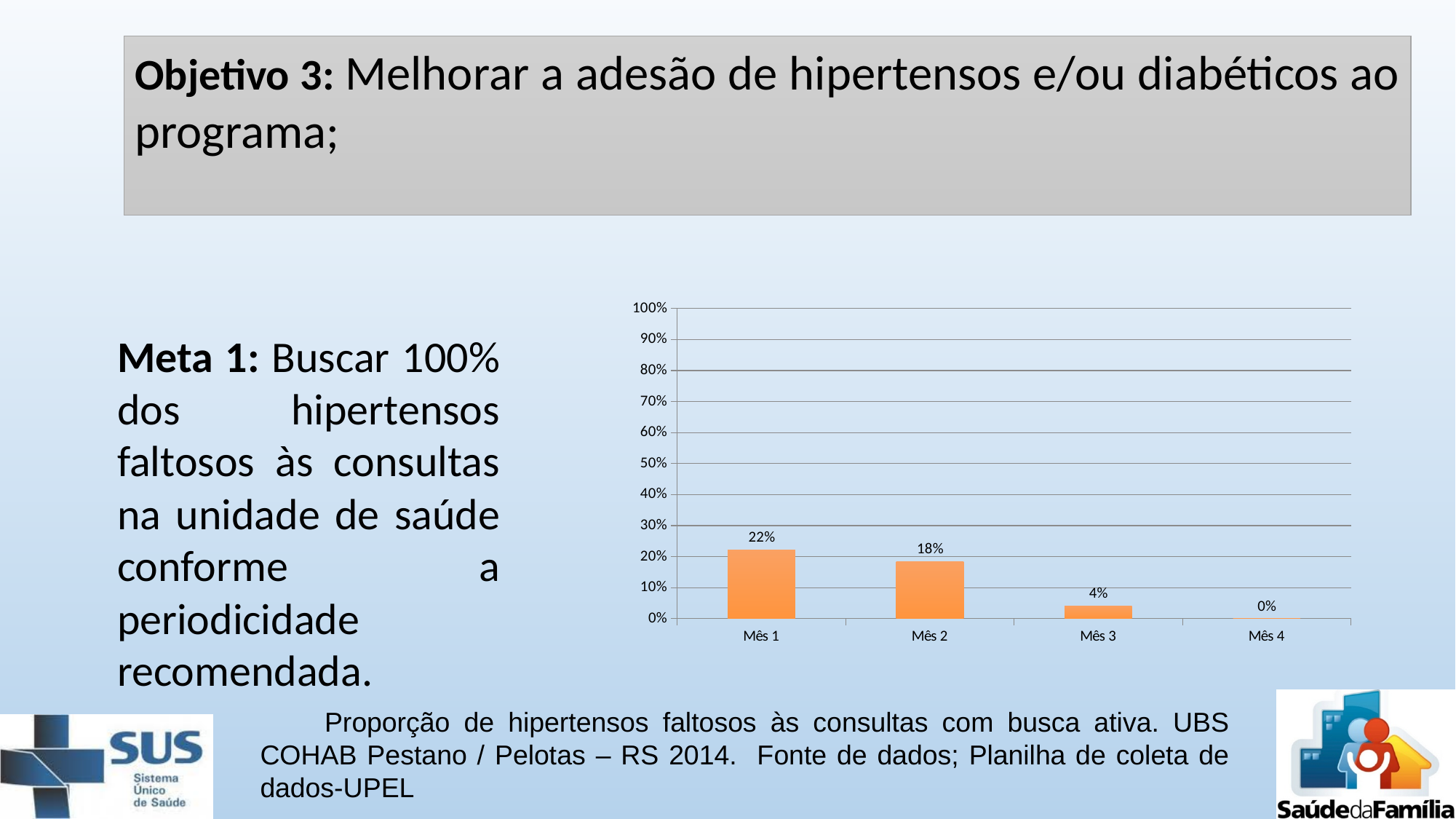
What is the difference between the values for Mês 1 and Mês 2? 4% Which month has the highest value? Mês 1 Which month has the lowest value? Mês 4 Is the value for Mês 1 greater or less than 30%? less Which is larger, the value for Mês 2 or the value for Mês 3? Mês 2 What is the difference between the values for Mês 2 and Mês 3? 14% What is the value for Mês 4? 0% What kind of chart is shown on the slide? bar chart What is the value for Mês 3? 4% What is the value for Mês 2? 18% What is the value for Mês 1? 22% How many months are shown on the x axis? 4